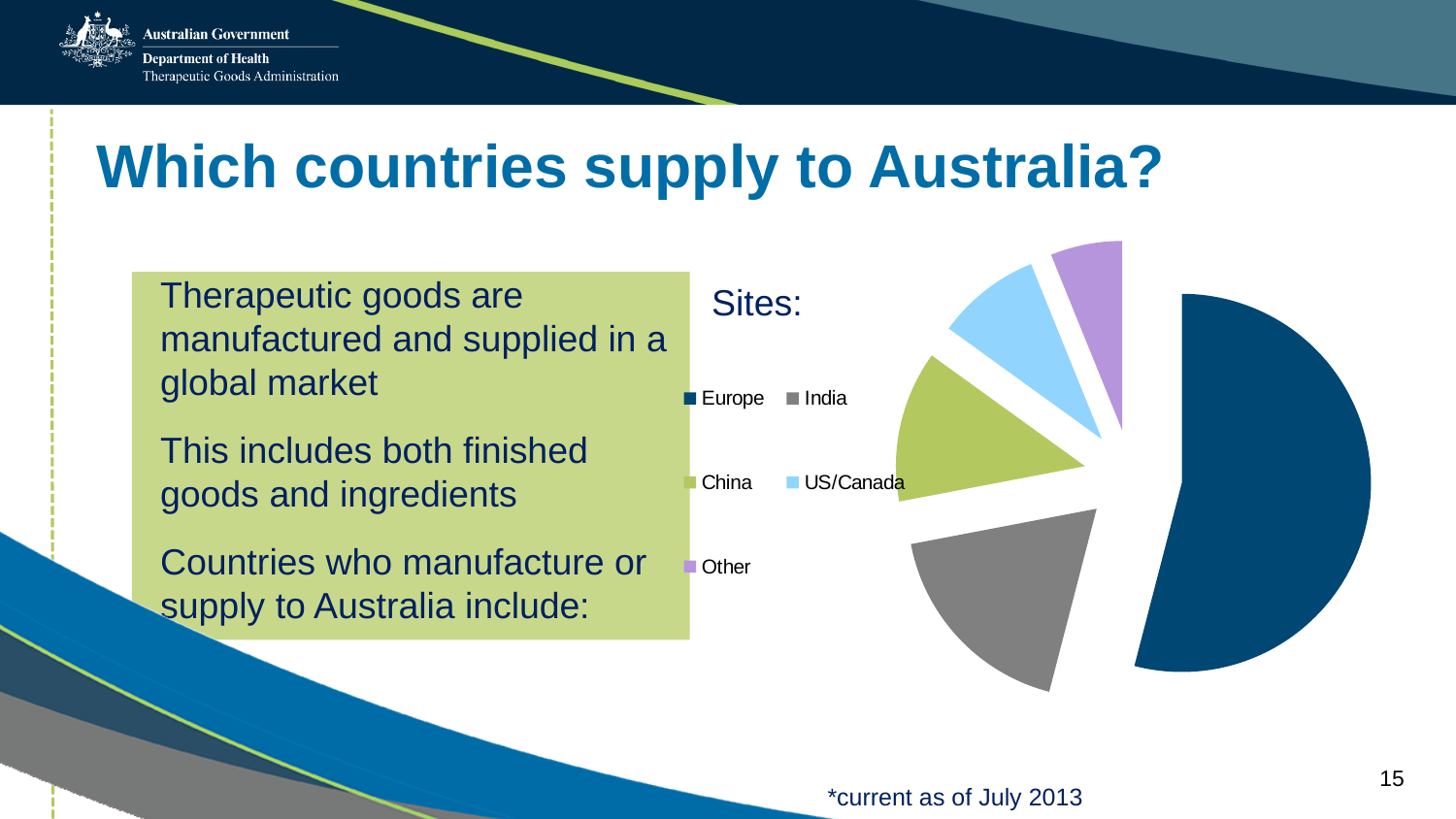
How many categories does the pie chart's legend list? 5 Which slice is larger in the pie chart, India or China? India Which slice is larger in the pie chart, Europe or India? Europe Which category has the largest slice of the pie chart? Europe What is the title of the pie chart? Sites: Which slice is larger in the pie chart, China or Other? China What colour is the Europe slice in the pie chart? dark blue Which category has the smallest slice of the pie chart? Other What kind of chart is shown on the slide? pie chart